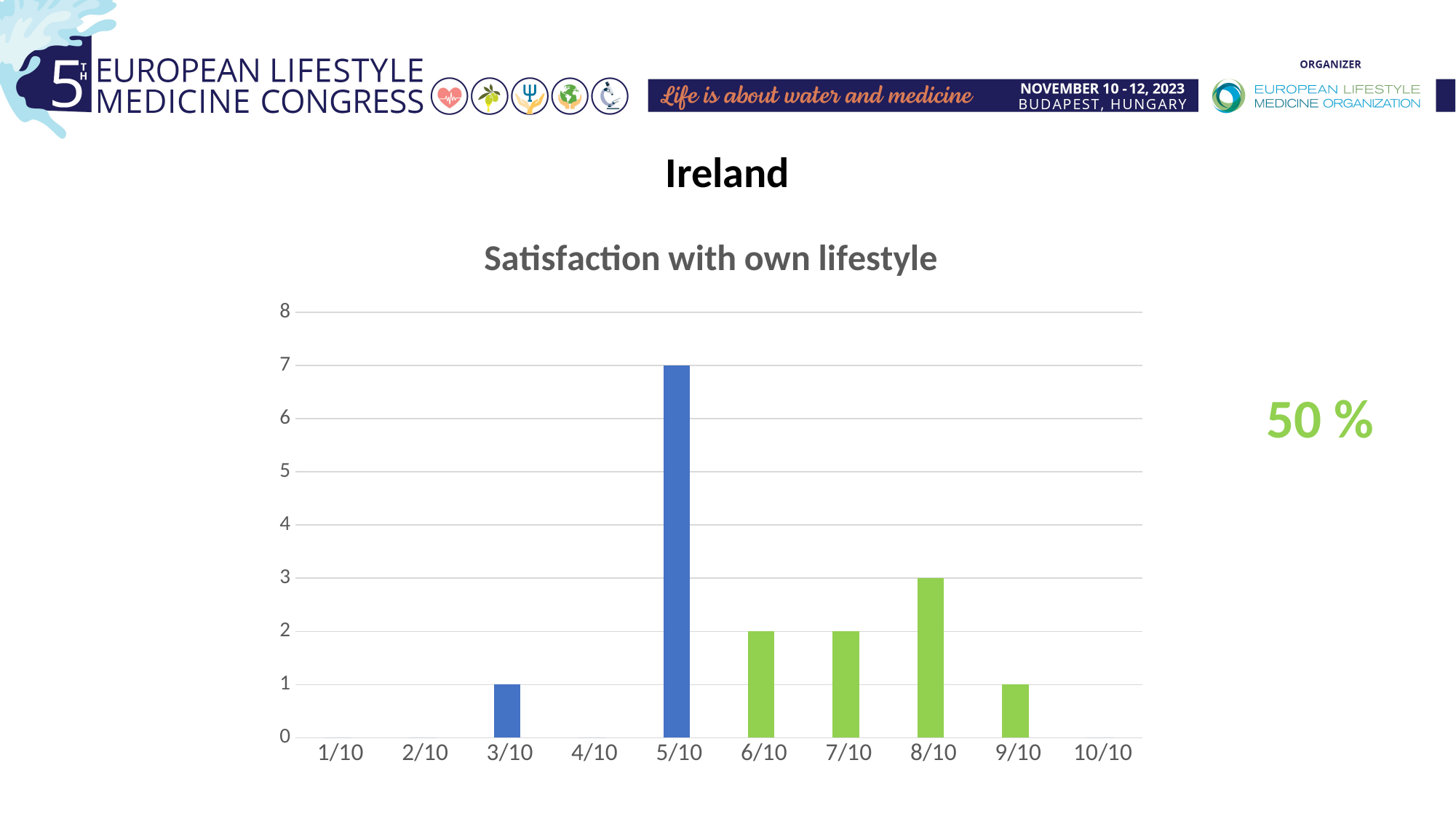
What is the title of the chart? Satisfaction with own lifestyle Which is larger, the value for 8/10 or the value for 9/10? 8/10 Is the value for 5/10 greater or less than 6? greater What is the value for 3/10? 1 What is the difference between the values for 5/10 and 8/10? 4 What is the value for 8/10? 3 Which category has the highest value in the chart? 5/10 How many categories are shown on the x axis of the chart? 10 What is the value for 5/10? 7 What is the value for 6/10? 2 What kind of chart is shown on the slide? bar chart What colour are the bars for 3/10 and 5/10? blue